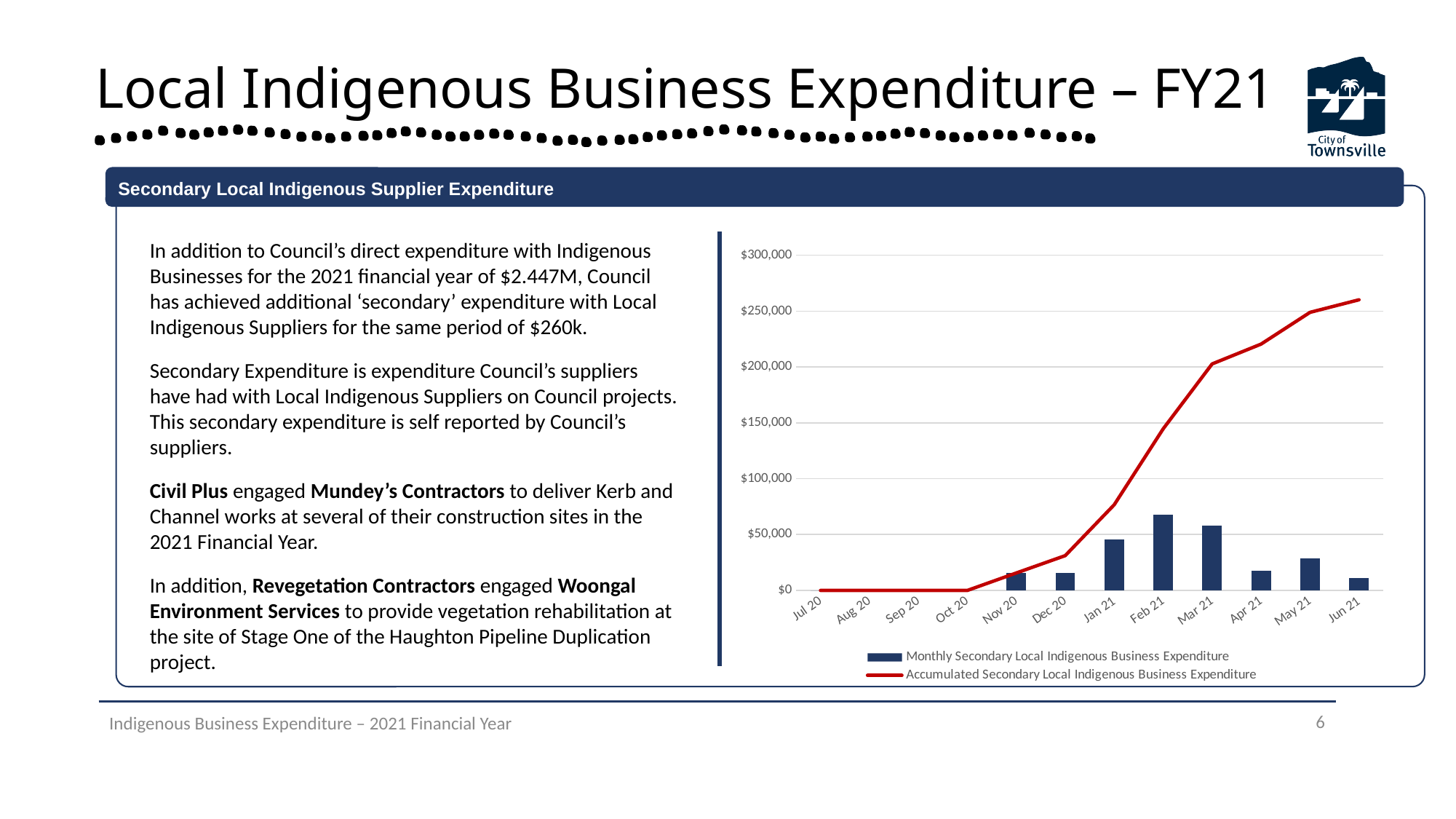
Which is larger, the monthly expenditure bar for Feb 21 or for Apr 21? Feb 21 Is the Accumulated Secondary Local Indigenous Business Expenditure for Jun 21 greater or less than $250,000? greater Does the Accumulated Secondary Local Indigenous Business Expenditure line rise or fall from Nov 20 to Jun 21? rise Which is larger, the monthly expenditure bar for Mar 21 or for May 21? Mar 21 What colour is the Accumulated Secondary Local Indigenous Business Expenditure line? Red How many months are shown on the x axis of the chart? 12 Which month has the highest Monthly Secondary Local Indigenous Business Expenditure bar? Feb 21 Is the Monthly Secondary Local Indigenous Business Expenditure for Jan 21 greater or less than $50,000? less Is the Accumulated Secondary Local Indigenous Business Expenditure for Mar 21 greater or less than $150,000? greater How many series does the chart legend list? 2 What kind of chart is shown on the slide? Combined bar and line chart